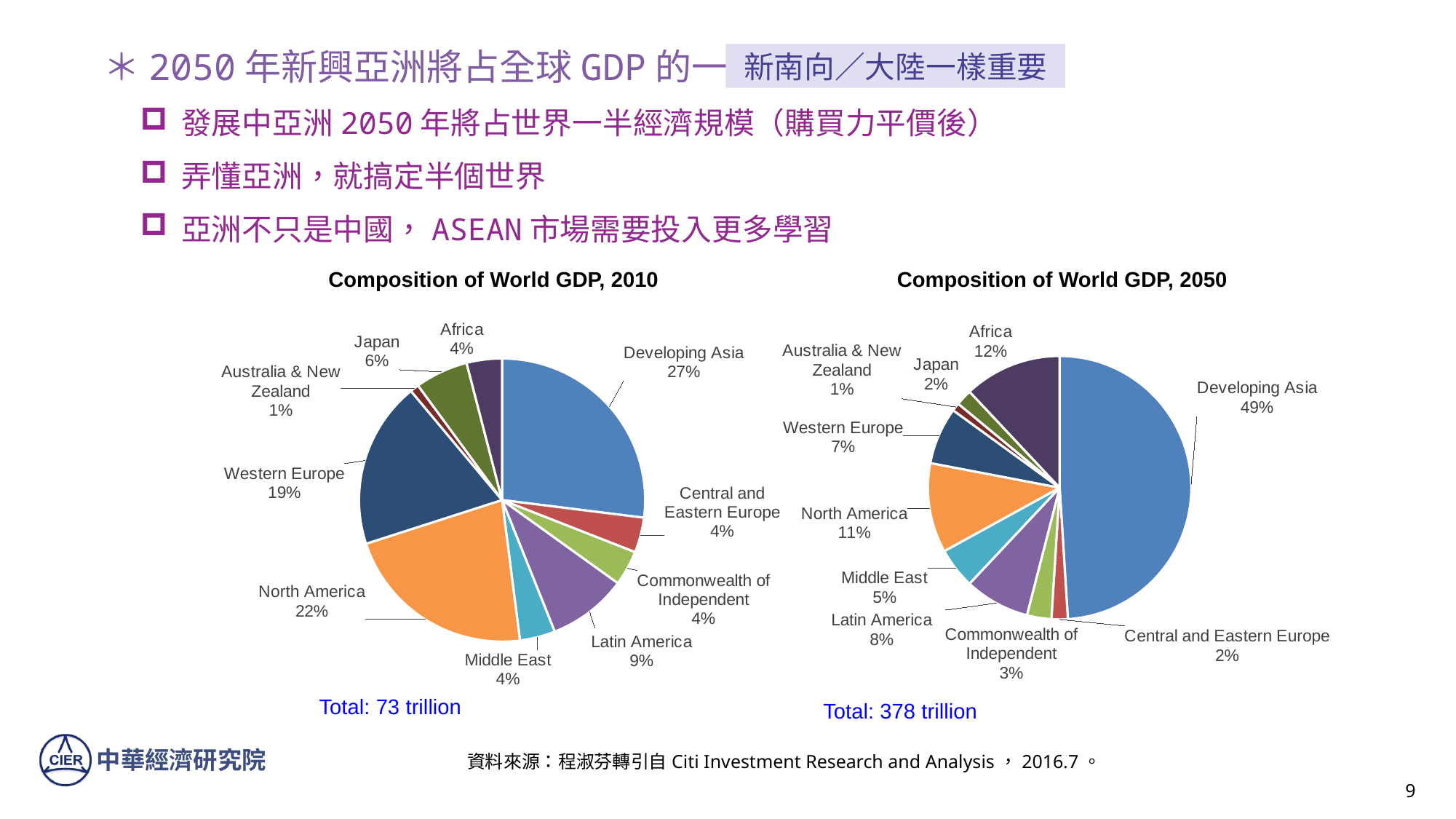
In the 'Composition of World GDP, 2010' chart, which region has the smallest share? Australia & New Zealand In the 'Composition of World GDP, 2010' chart, what share does Developing Asia have? 27% What total is printed below the 'Composition of World GDP, 2050' chart? Total: 378 trillion In the 'Composition of World GDP, 2050' chart, which is larger, the share of North America or the share of Western Europe? North America In the 'Composition of World GDP, 2050' chart, what share does Africa have? 12% In the 'Composition of World GDP, 2010' chart, what is the difference between the shares of North America and Western Europe? 3% What total is printed below the 'Composition of World GDP, 2010' chart? Total: 73 trillion What kind of chart is 'Composition of World GDP, 2050'? Pie chart How many regions are shown in the 'Composition of World GDP, 2010' pie chart? 10 In the 'Composition of World GDP, 2050' chart, what share does Developing Asia have? 49% In the 'Composition of World GDP, 2010' chart, what share does North America have? 22% In the 'Composition of World GDP, 2050' chart, which region has the largest share? Developing Asia